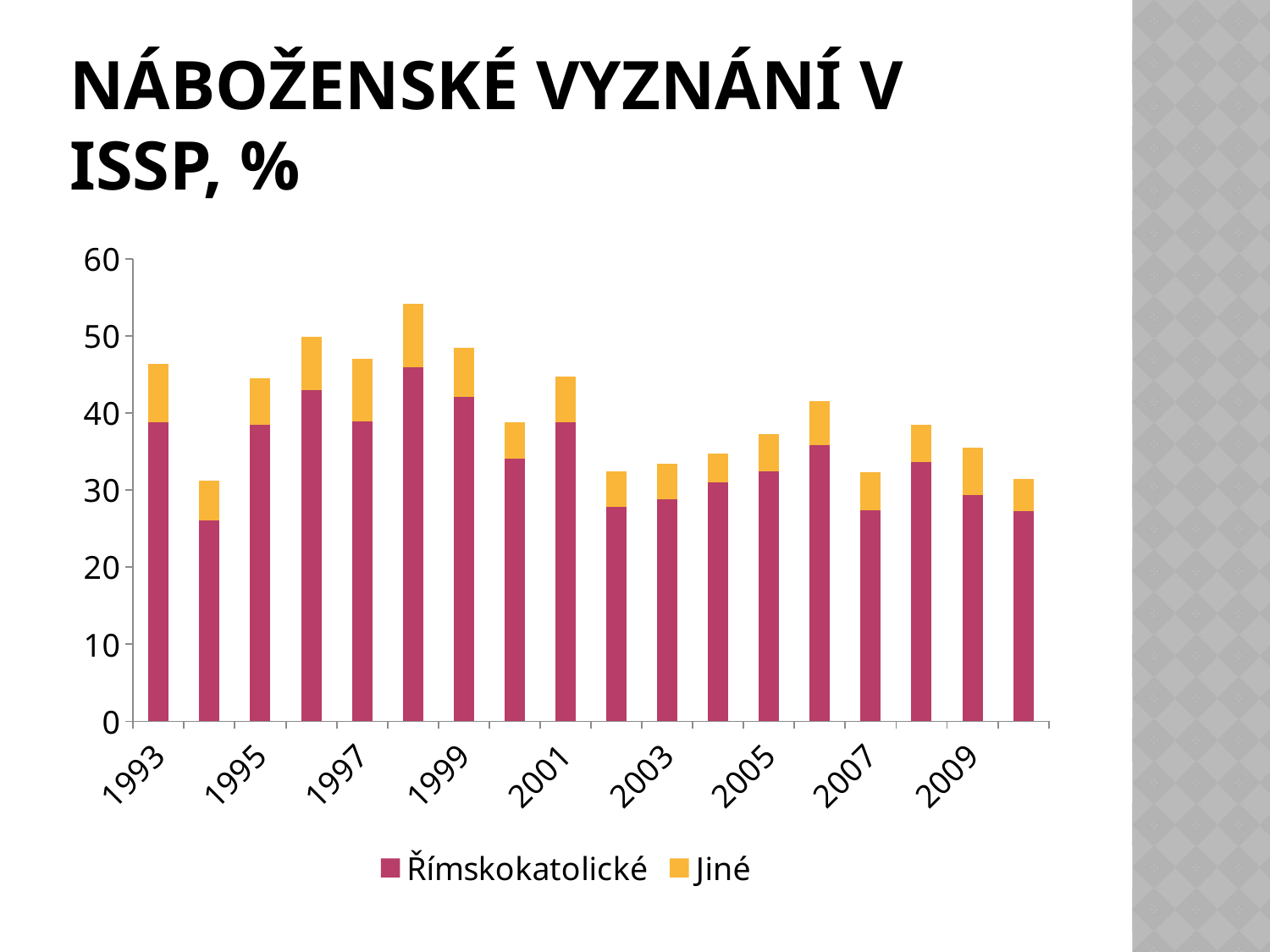
Is the total value for 1993 greater or less than 40? greater How many series does the legend list? 2 What are the two series named in the legend? Římskokatolické and Jiné Is the Římskokatolické value for 2003 greater or less than 30? less What kind of chart is shown on the slide? bar chart Is the total value for 1994 greater or less than 40? less Which year has the highest total bar? 1998 Which year has the larger total bar, 1996 or 1997? 1996 Which year has the highest value for Římskokatolické? 1998 Do the total values generally rise or fall from 1998 to 2003? fall How many bars (years) are plotted in the chart? 18